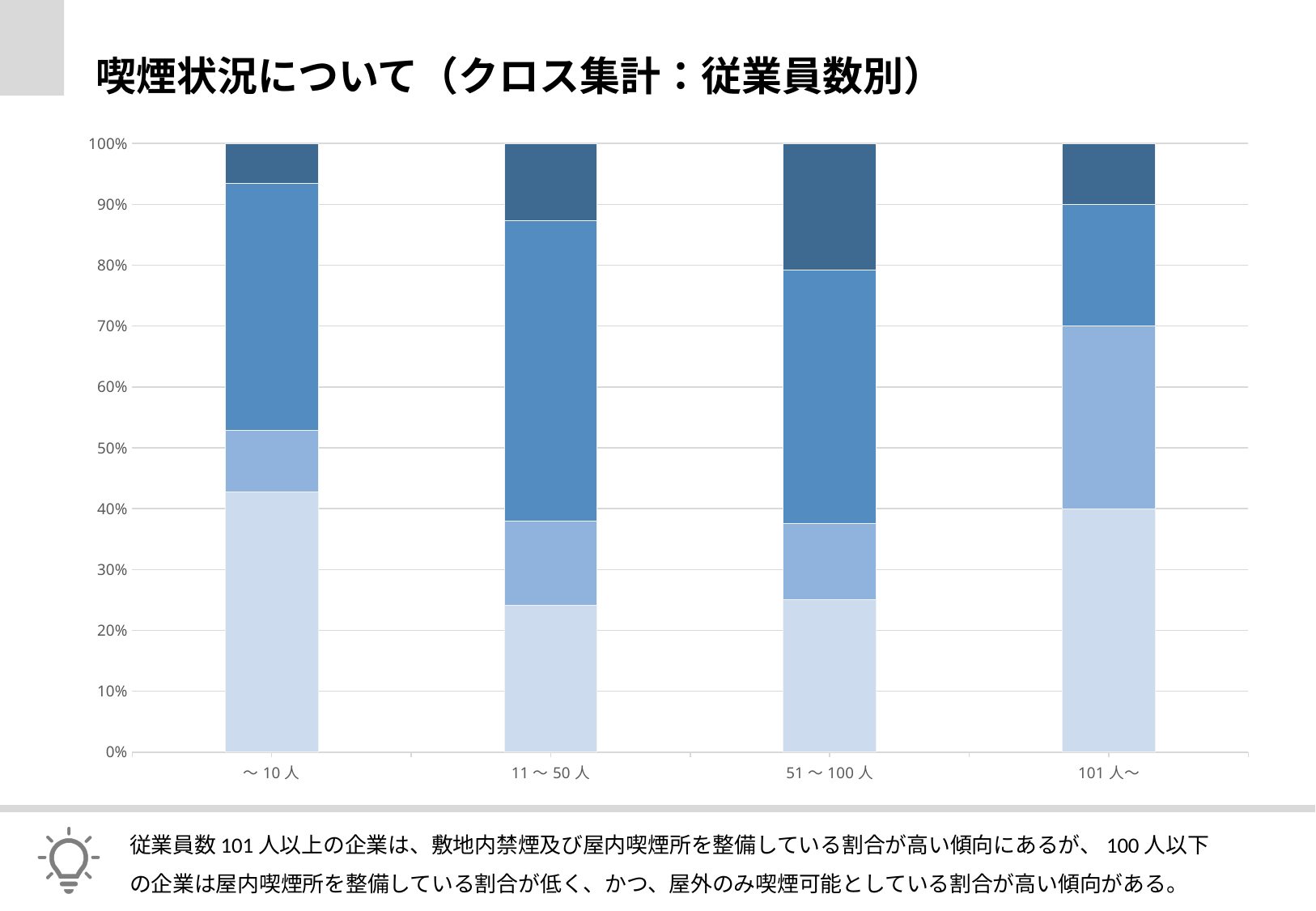
Is the bottom (lightest) segment for 11 ～ 50 人 greater or less than 30%? less What is the title of the slide? 喫煙状況について（クロス集計：従業員数別） How many employee-size categories are shown on the x axis? 4 Is the bottom (lightest) segment larger for 101 人～ or for 11 ～ 50 人? 101 人～ Is the bottom (lightest) segment for ～10 人 greater or less than 40%? greater What kind of chart is shown on the slide? Stacked bar chart Is the top of the third segment from the bottom for ～10 人 greater or less than 90%? greater Which category has the largest bottom (lightest) segment? ～10 人 Which category has the largest top (darkest) segment? 51 ～ 100 人 Which category has the smallest top (darkest) segment? ～10 人 What is the label of the rightmost category on the x axis? 101 人～